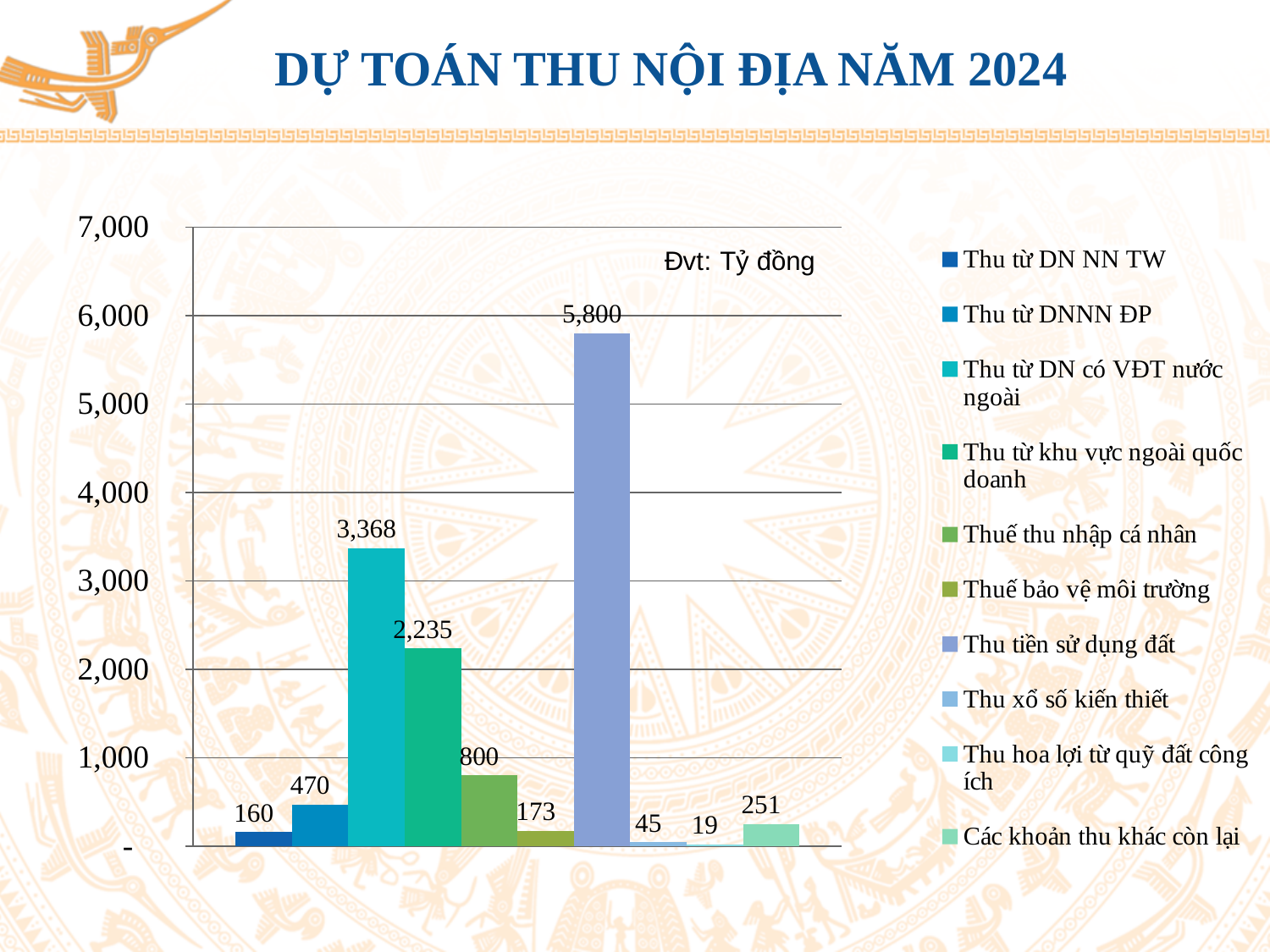
Which series has the lowest value? Thu hoa lợi từ quỹ đất công ích What is the value for Thu tiền sử dụng đất? 5,800 What is the value for Thu hoa lợi từ quỹ đất công ích? 19 What unit is stated on the chart? Tỷ đồng What is the value for Thu từ DN có VĐT nước ngoài? 3,368 How many series does the legend list? 10 Is the value for Thu từ khu vực ngoài quốc doanh greater or less than 2,000? greater Which series has the highest value? Thu tiền sử dụng đất What kind of chart is shown on the slide? Bar chart Which is larger, Thu từ DNNN ĐP or Các khoản thu khác còn lại? Thu từ DNNN ĐP What is the difference between Thu tiền sử dụng đất and Thu từ DN có VĐT nước ngoài? 2,432 What is the value for Thuế thu nhập cá nhân? 800